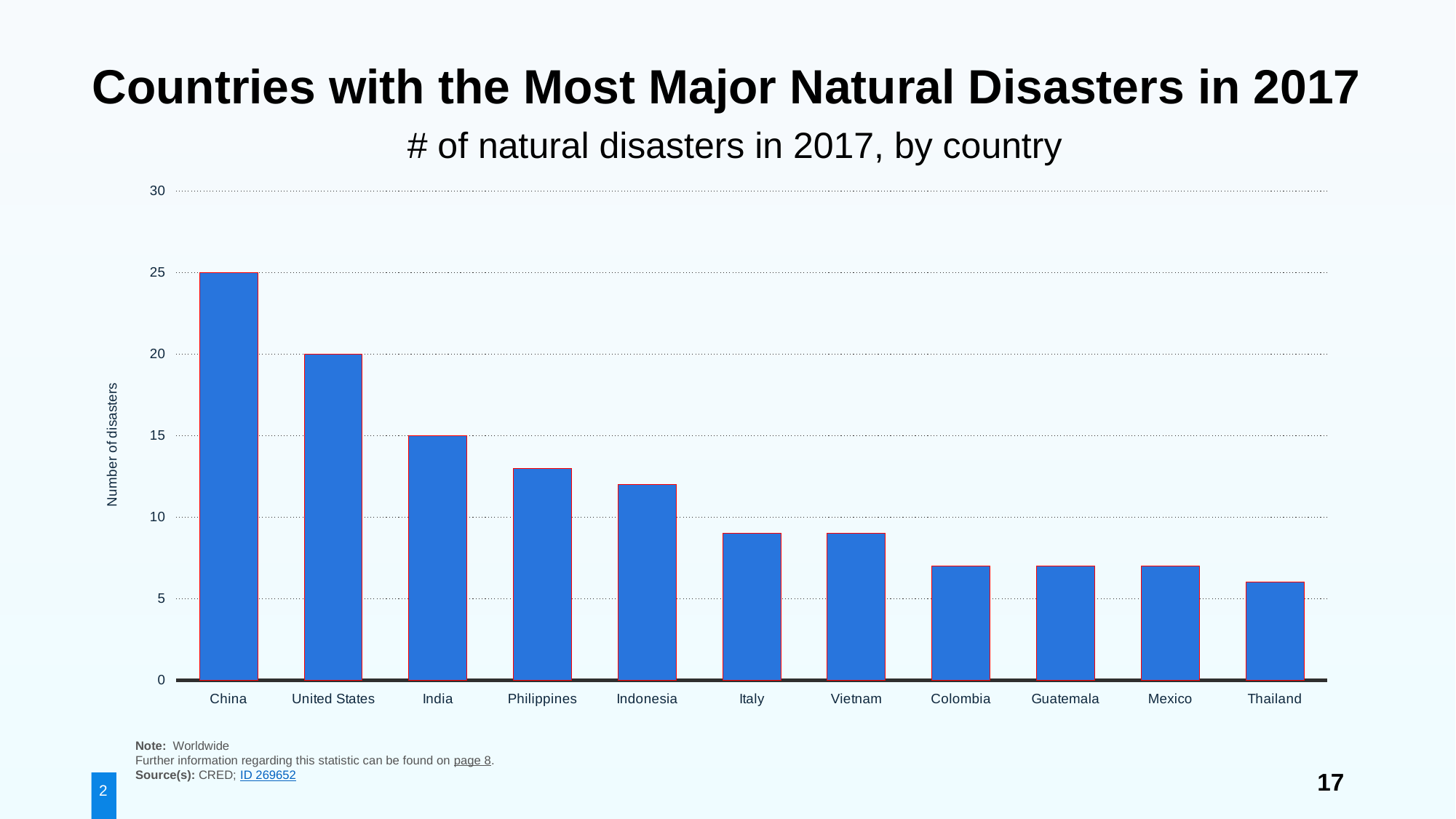
How many natural disasters did the United States have in 2017? 20 How many natural disasters did India have in 2017? 15 How many natural disasters did China have in 2017? 25 Is the value for the Philippines greater or less than 10? greater Do the values rise or fall from left to right across the countries? fall Which country has the highest number of natural disasters in 2017? China What is the difference between the number of natural disasters in China and in the United States? 5 Which has more natural disasters, India or Italy? India Is the value for Italy greater or less than 10? less Which country has the lowest number of natural disasters in 2017? Thailand What type of chart is shown on the slide? bar chart How many countries are shown in the chart? 11